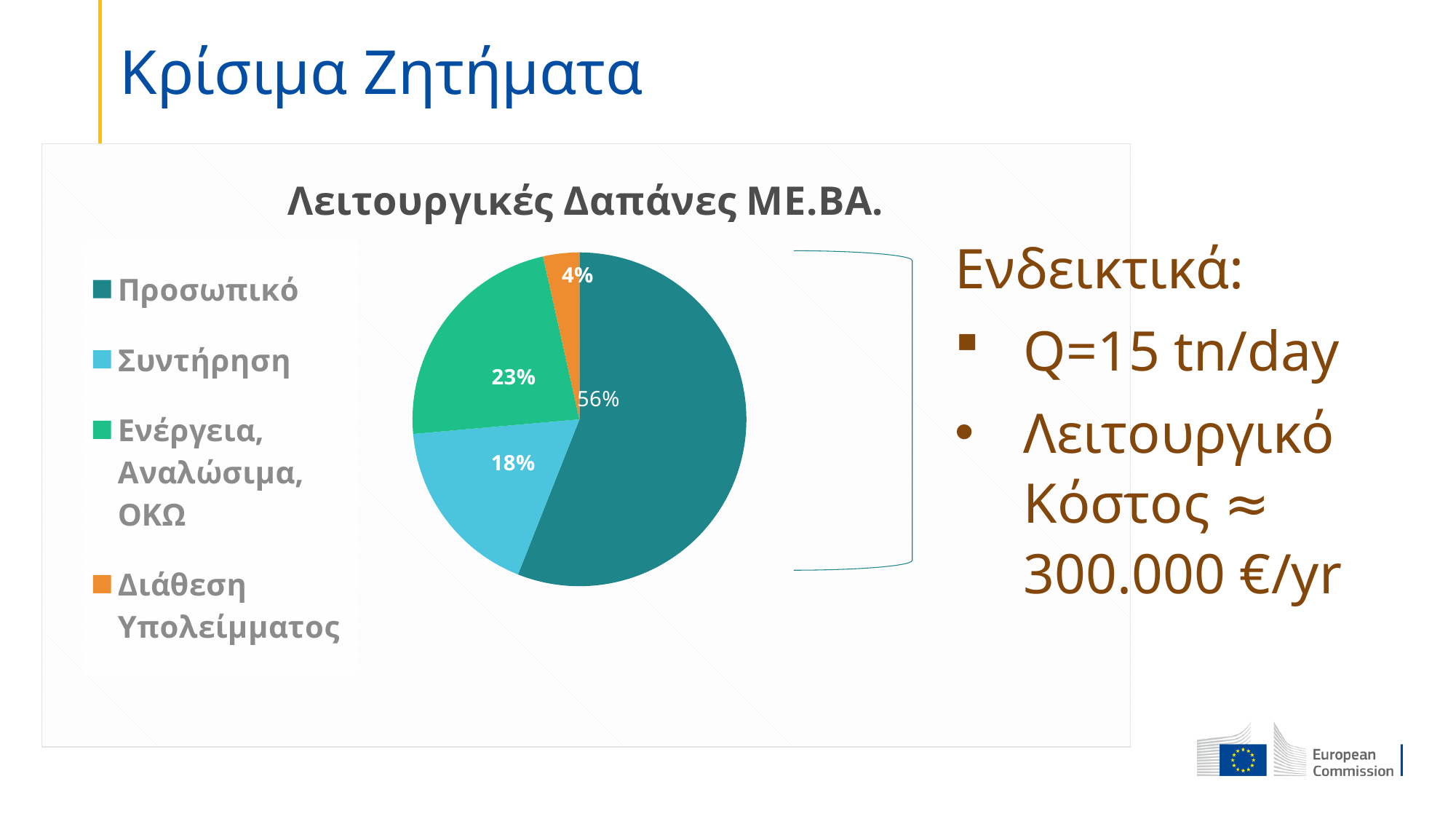
What share of the pie does Ενέργεια, Αναλώσιμα, ΟΚΩ represent? 23% Which category has the smallest share of the pie? Διάθεση Υπολείμματος What type of chart is shown on the slide? pie chart What is the title of the chart? Λειτουργικές Δαπάνες ΜΕ.ΒΑ. How many categories does the pie chart have? 4 What share of the pie does Διάθεση Υπολείμματος represent? 4% What share of the pie does Προσωπικό represent? 56% What colour is the slice for Διάθεση Υπολείμματος? orange What is the difference in percentage points between Προσωπικό and Συντήρηση? 38 Which is larger, the share for Συντήρηση or the share for Ενέργεια, Αναλώσιμα, ΟΚΩ? Ενέργεια, Αναλώσιμα, ΟΚΩ Which category has the largest share of the pie? Προσωπικό